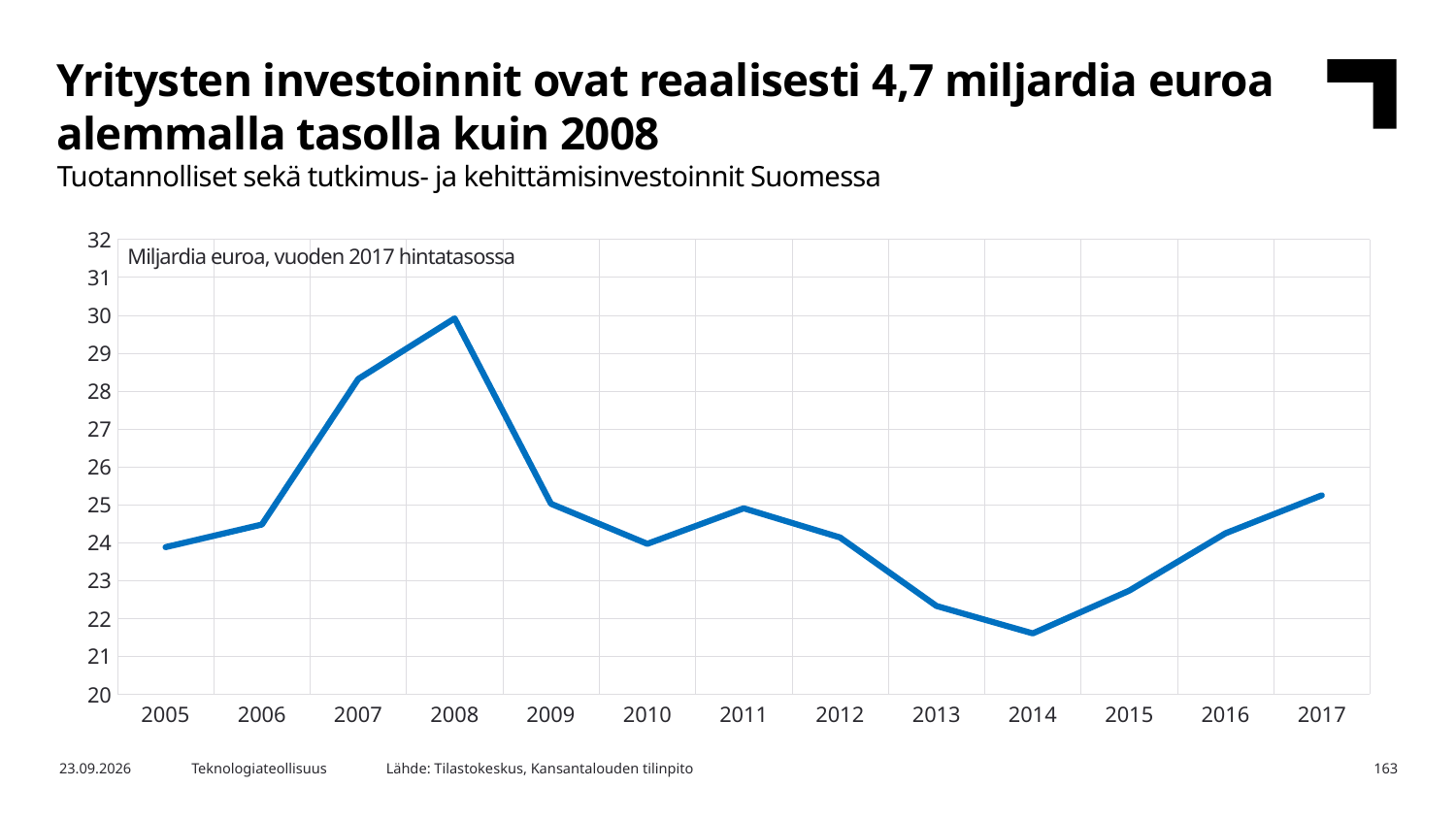
Is the value for 2013 greater or less than 23? less How many years are plotted on the x axis? 13 Do the values rise or fall from 2014 to 2017? rise Is the value for 2006 greater or less than 24? greater What unit label is shown inside the chart area? Miljardia euroa, vuoden 2017 hintatasossa Which year has the lowest investment value on the chart? 2014 Is the value for 2008 greater or less than 29? greater Which year has the larger value, 2007 or 2013? 2007 What kind of chart is shown on the slide? Line chart Which year has the highest investment value on the chart? 2008 Do the values rise or fall from 2008 to 2014? fall